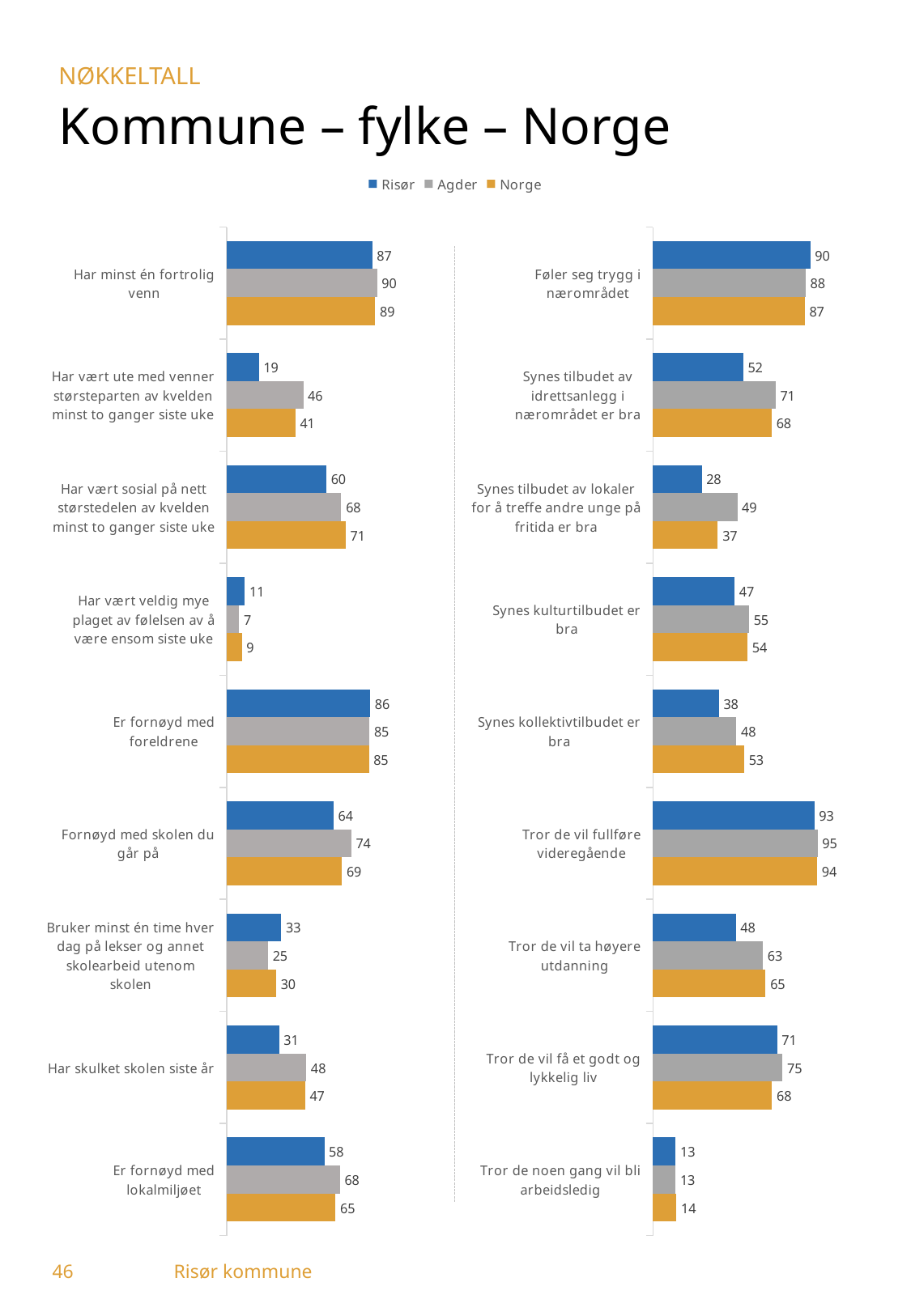
In the left chart, what is the difference between the Agder and Risør values for 'Har skulket skolen siste år'? 17 How many series does the legend list? 3 In the right chart, which is larger for 'Synes tilbudet av lokaler for å treffe andre unge på fritida er bra': the Agder value or the Norge value? Agder What type of chart is used on this slide? Bar chart In the left chart, what is the Risør value for 'Har vært ute med venner størsteparten av kvelden minst to ganger siste uke'? 19 Which series is shown in orange in the legend? Norge In the right chart, what is the Agder value for 'Synes tilbudet av idrettsanlegg i nærområdet er bra'? 71 In the right chart, what is the Norge value for 'Tror de vil ta høyere utdanning'? 65 In the right chart, which category has the highest Risør value? Tror de vil fullføre videregående In the left chart, which is larger for 'Bruker minst én time hver dag på lekser og annet skolearbeid utenom skolen': the Risør value or the Agder value? Risør In the left chart, which category has the lowest Risør value? Har vært veldig mye plaget av følelsen av å være ensom siste uke How many categories does the left chart show? 9